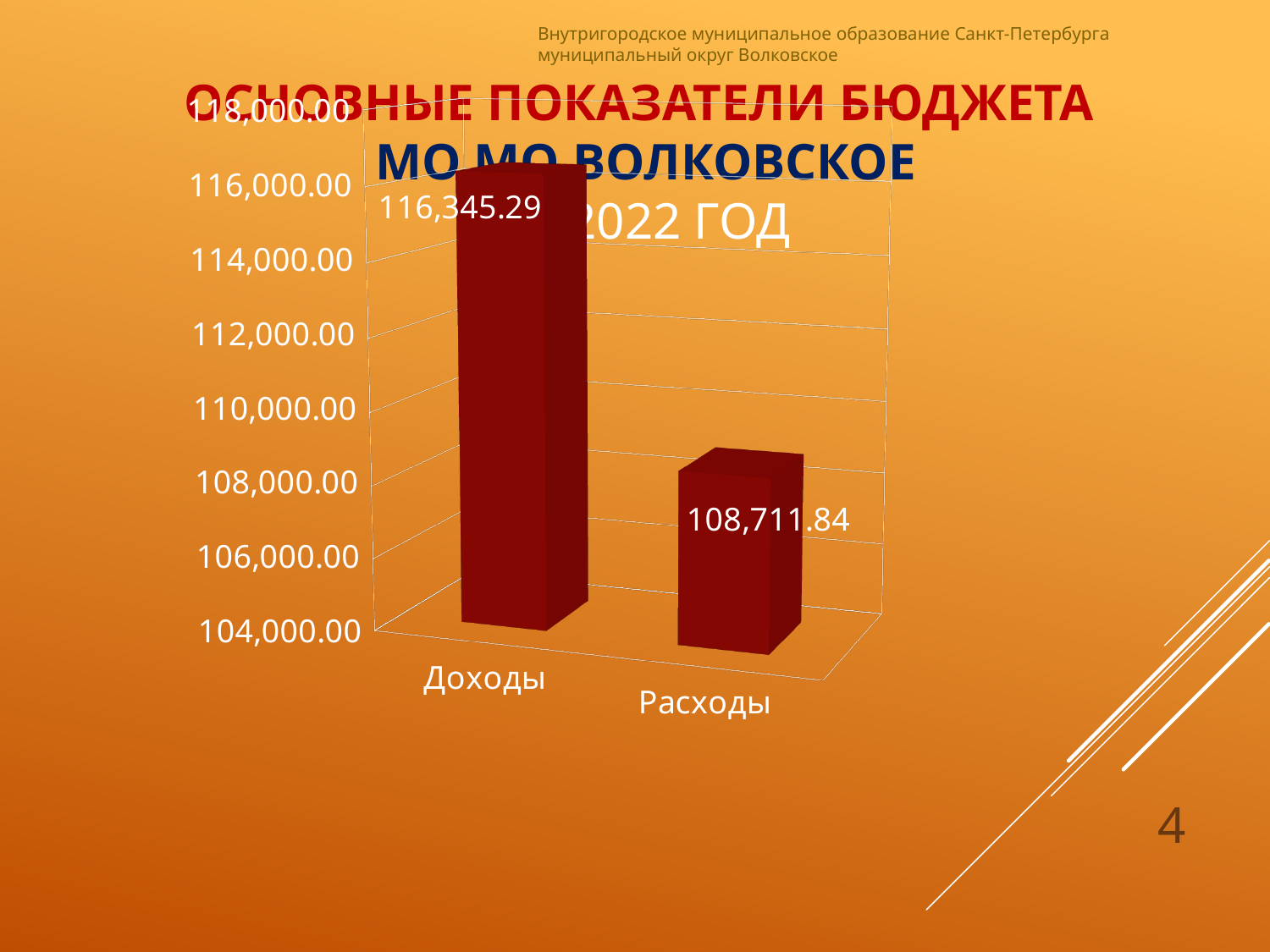
Is the value for Расходы greater or less than 110,000.00? less What is the difference between the values for Доходы and Расходы? 7,633.45 Which category has the lowest value? Расходы What is the value for Доходы? 116,345.29 What is the highest value shown on the vertical axis? 118,000.00 What is the value for Расходы? 108,711.84 How many categories are shown on the chart? 2 What is the lowest value shown on the vertical axis? 104,000.00 Is the value for Доходы greater or less than 114,000.00? greater Which is larger, Доходы or Расходы? Доходы What kind of chart is shown on the slide? bar chart Which category has the highest value? Доходы